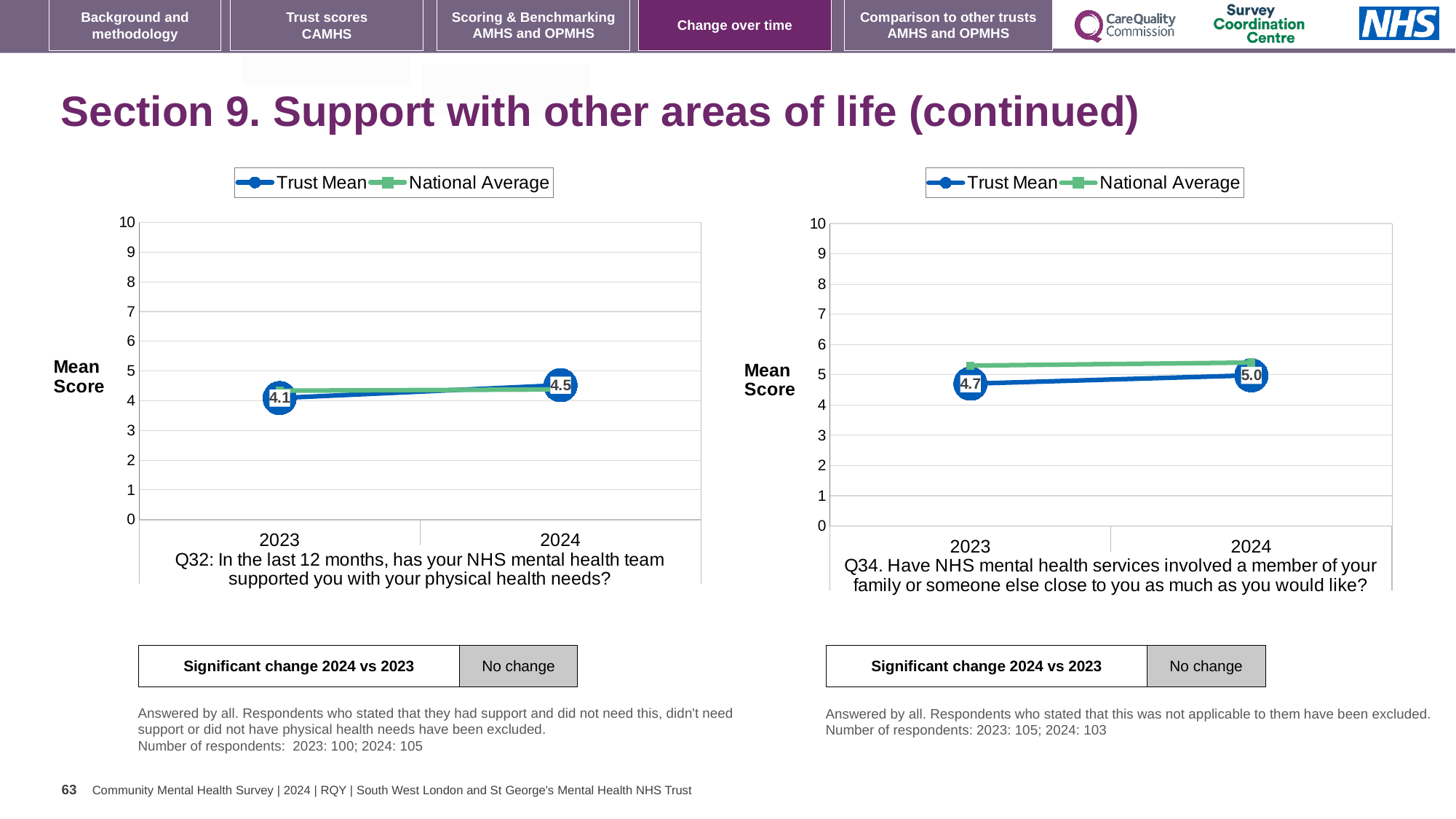
In the left chart (Q32), by how much did the Trust Mean change from 2023 to 2024? 0.4 What kind of chart is the left chart (Q32)? line chart How many series does the legend of the right chart (Q34) list? 2 In the right chart (Q34), is the National Average value for 2023 greater or less than 5? greater In the left chart (Q32), which year has the higher Trust Mean score? 2024 In the left chart (Q32), what is the Trust Mean score for 2024? 4.5 How many years are plotted on the x axis of the left chart (Q32)? 2 In the left chart (Q32), what is the Trust Mean score for 2023? 4.1 In the right chart (Q34), what is the difference between the Trust Mean for 2024 and 2023? 0.3 In the right chart (Q34), does the Trust Mean rise or fall from 2023 to 2024? rise In the right chart (Q34), what is the Trust Mean score for 2023? 4.7 In the right chart (Q34), what is the Trust Mean score for 2024? 5.0